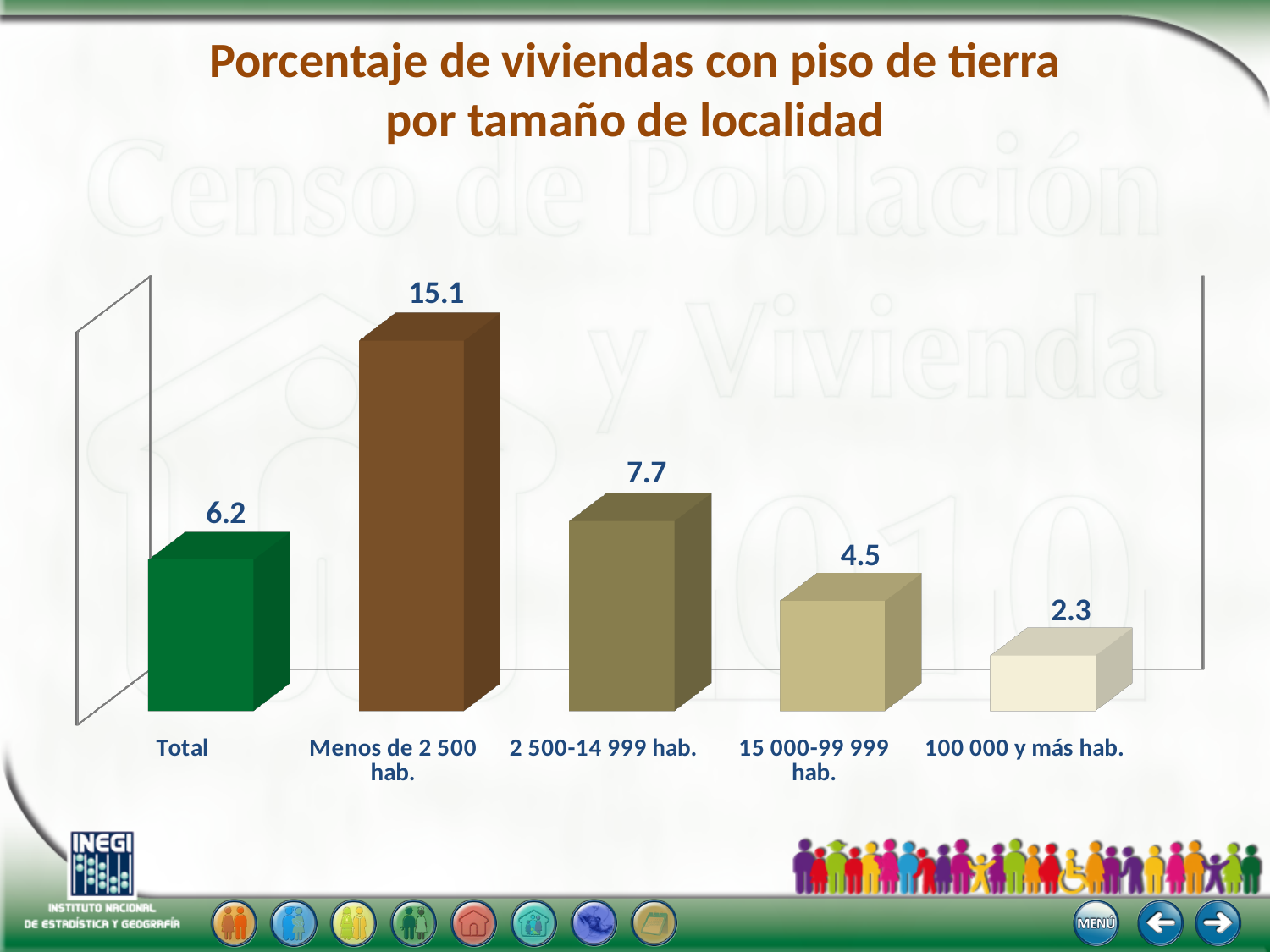
What is the value for 15 000-99 999 hab.? 4.5 What is the value for 2 500-14 999 hab.? 7.7 Which category has the highest value? Menos de 2 500 hab. How many categories are shown in the chart? 5 What is the value for 100 000 y más hab.? 2.3 What kind of chart is shown on the slide? Bar chart Which is larger, the value for 2 500-14 999 hab. or the value for Total? 2 500-14 999 hab. What is the value for Total? 6.2 Which category has the lowest value? 100 000 y más hab. What is the value for Menos de 2 500 hab.? 15.1 What is the title of the chart? Porcentaje de viviendas con piso de tierra por tamaño de localidad What is the difference between the values for Menos de 2 500 hab. and 100 000 y más hab.? 12.8